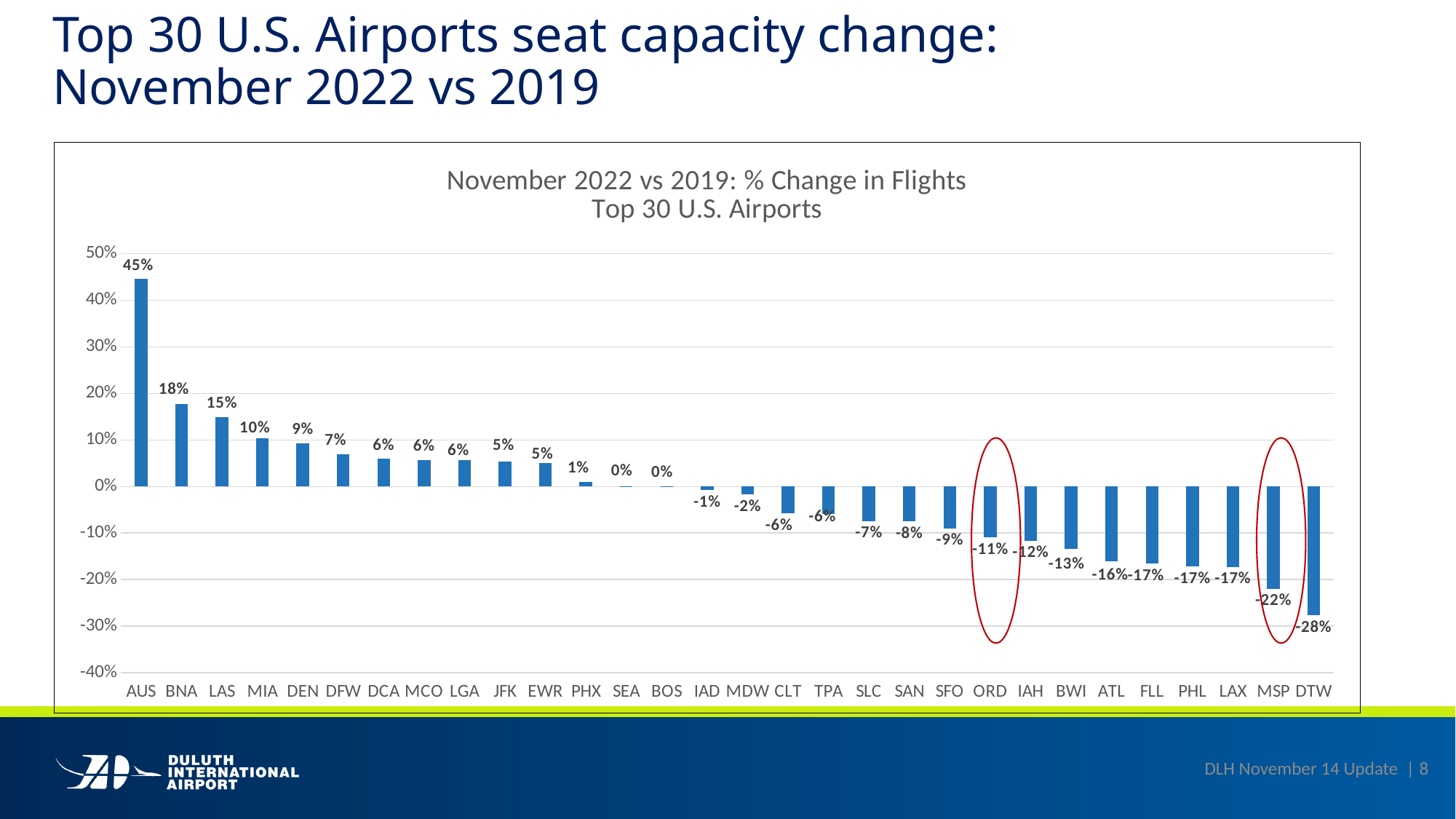
Which airport has the lowest value? DTW What is the difference between the values for MSP and DTW? 6% How many airports are shown on the x axis? 30 What is the value for DEN? 9% Do the values rise or fall from left to right along the x axis? Fall Which airport has the highest value? AUS What is the value for AUS? 45% What is the value for MSP? -22% What kind of chart is this? Bar chart Which has a larger value, LAS or MIA? LAS What is the value for ORD? -11% What is the difference between the values for AUS and BNA? 27%